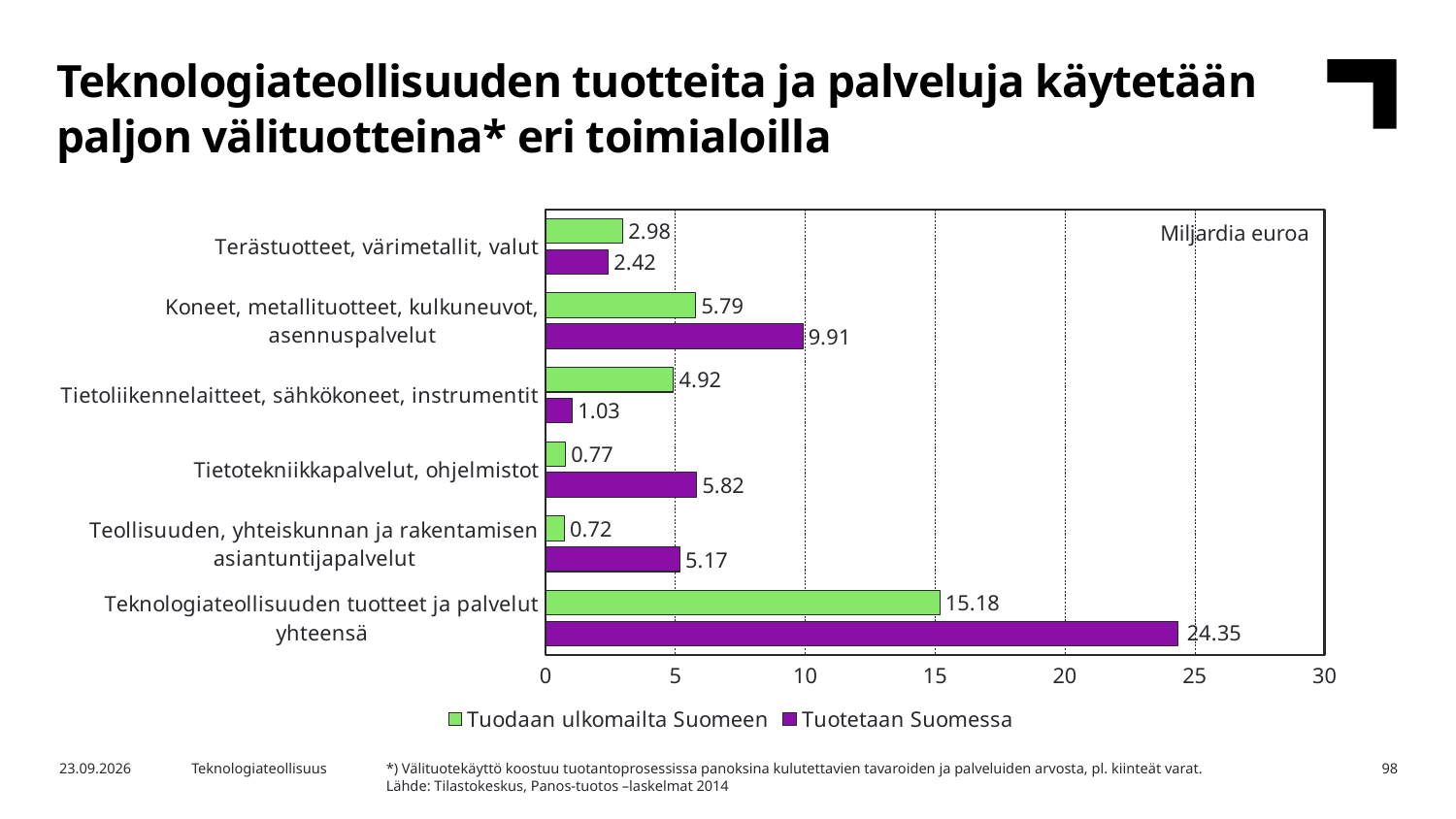
What is the value for "Tuodaan ulkomailta Suomeen" in the category "Tietoliikennelaitteet, sähkökoneet, instrumentit"? 4.92 What kind of chart is shown on the slide? Bar chart What is the value for "Tuotetaan Suomessa" in the category "Koneet, metallituotteet, kulkuneuvot, asennuspalvelut"? 9.91 Is the value for "Tuotetaan Suomessa" in "Teknologiateollisuuden tuotteet ja palvelut yhteensä" greater or less than 20? greater Excluding the total row "Teknologiateollisuuden tuotteet ja palvelut yhteensä", which category has the highest value for "Tuotetaan Suomessa"? Koneet, metallituotteet, kulkuneuvot, asennuspalvelut How many categories are shown on the chart? 6 What unit is stated in the top right corner of the chart? Miljardia euroa What is the difference between "Tuotetaan Suomessa" and "Tuodaan ulkomailta Suomeen" for "Teknologiateollisuuden tuotteet ja palvelut yhteensä"? 9.17 Which category has the lowest value for "Tuodaan ulkomailta Suomeen"? Teollisuuden, yhteiskunnan ja rakentamisen asiantuntijapalvelut How many series does the legend list? 2 What is the value for "Tuotetaan Suomessa" in the category "Teollisuuden, yhteiskunnan ja rakentamisen asiantuntijapalvelut"? 5.17 For "Terästuotteet, värimetallit, valut", which is larger: "Tuodaan ulkomailta Suomeen" or "Tuotetaan Suomessa"? Tuodaan ulkomailta Suomeen